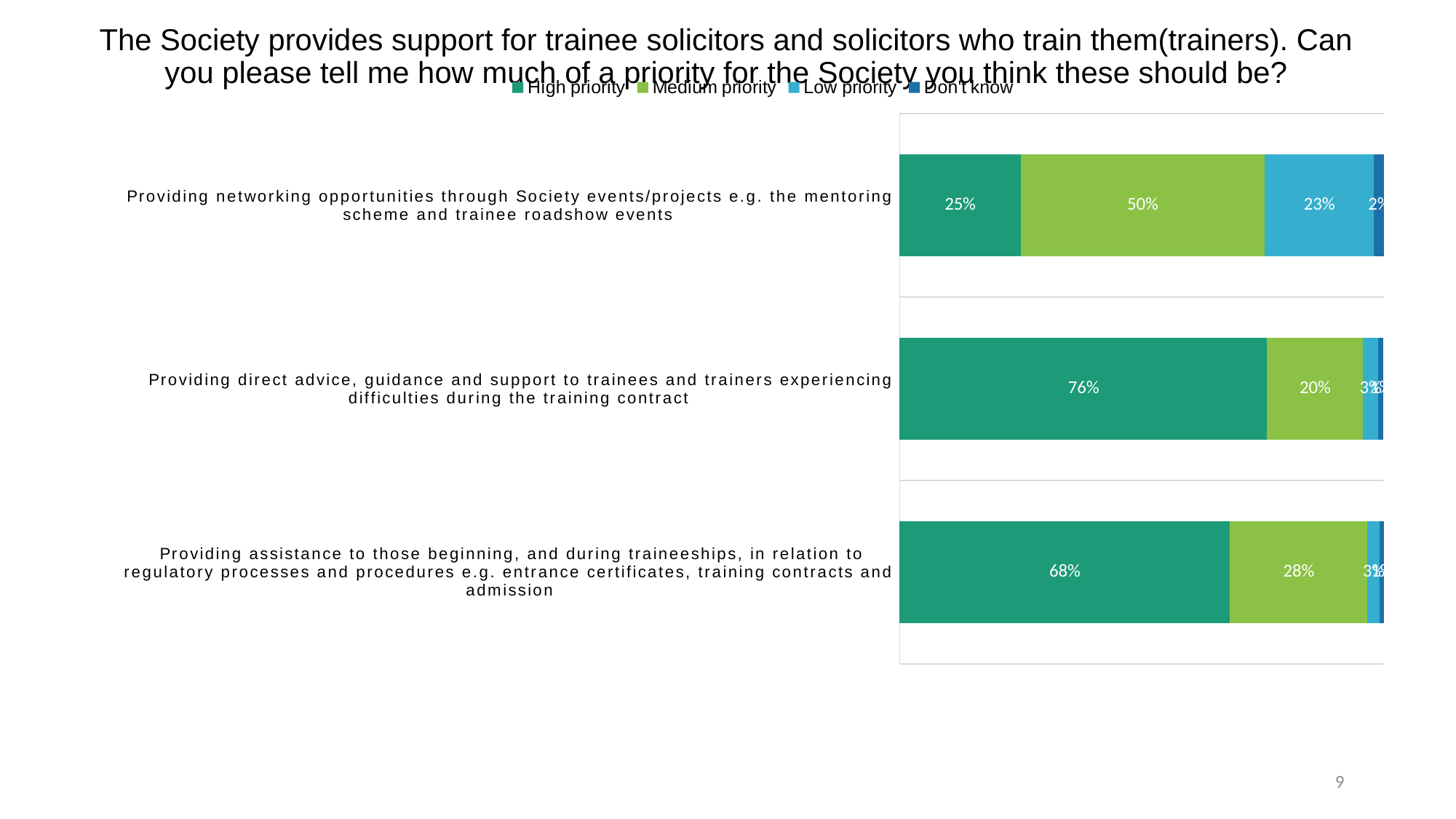
How many categories (support areas) are plotted in the chart? 3 What percentage rated 'Providing assistance to those beginning, and during traineeships, in relation to regulatory processes and procedures' as Medium priority? 28% Which is larger: the Medium priority percentage for 'Providing networking opportunities' or the Medium priority percentage for 'Providing direct advice, guidance and support'? Providing networking opportunities What kind of chart is shown on the slide? Stacked bar chart What percentage rated 'Providing direct advice, guidance and support to trainees and trainers experiencing difficulties' as High priority? 76% Which support area has the highest High priority percentage? Providing direct advice, guidance and support to trainees and trainers experiencing difficulties during the training contract What percentage rated 'Providing networking opportunities through Society events/projects' as Medium priority? 50% What percentage rated 'Providing networking opportunities through Society events/projects' as High priority? 25% What is the Low priority percentage for 'Providing networking opportunities through Society events/projects'? 23% Which support area has the lowest High priority percentage? Providing networking opportunities through Society events/projects e.g. the mentoring scheme and trainee roadshow events How many series does the legend list? 4 What is the difference between the High priority percentages for 'Providing direct advice, guidance and support' and 'Providing assistance to those beginning, and during traineeships'? 8%